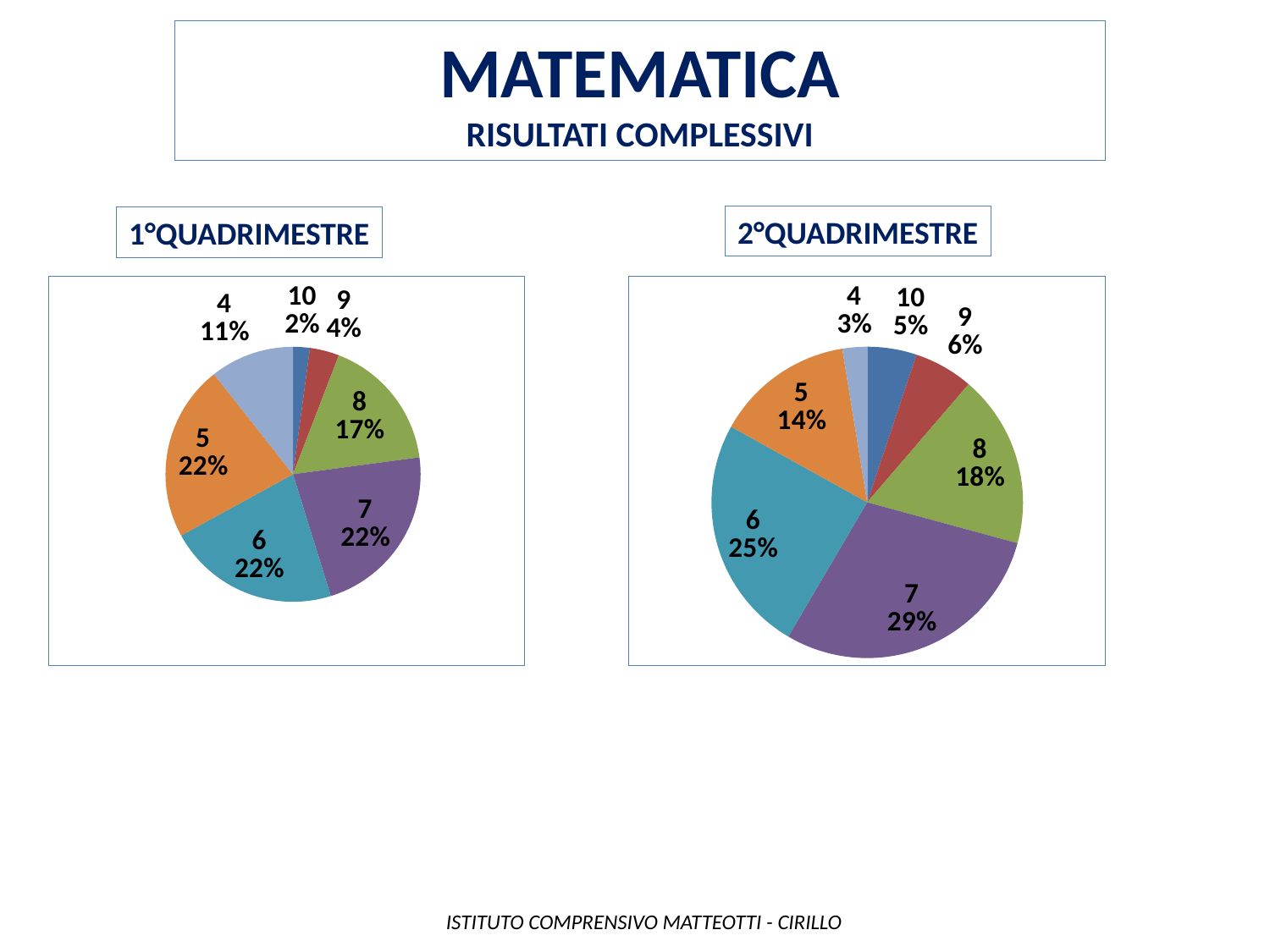
What kind of chart is used for the 1°QUADRIMESTRE results? pie chart In the 2°QUADRIMESTRE chart, what share does grade 5 have? 14% In the 2°QUADRIMESTRE chart, what is the difference between the shares of grade 7 and grade 6? 4% In the 2°QUADRIMESTRE chart, which is larger, the share of grade 6 or the share of grade 8? grade 6 In the 2°QUADRIMESTRE chart, what share does grade 7 have? 29% In the 1°QUADRIMESTRE chart, which grade has the smallest slice? 10 In the 2°QUADRIMESTRE chart, which grade has the largest slice? 7 In the 1°QUADRIMESTRE chart, what is the difference between the shares of grade 8 and grade 9? 13% In the 1°QUADRIMESTRE chart, what share does grade 4 have? 11% In the 2°QUADRIMESTRE chart, which grade has the smallest slice? 4 In the 1°QUADRIMESTRE chart, how many slices does the pie have? 7